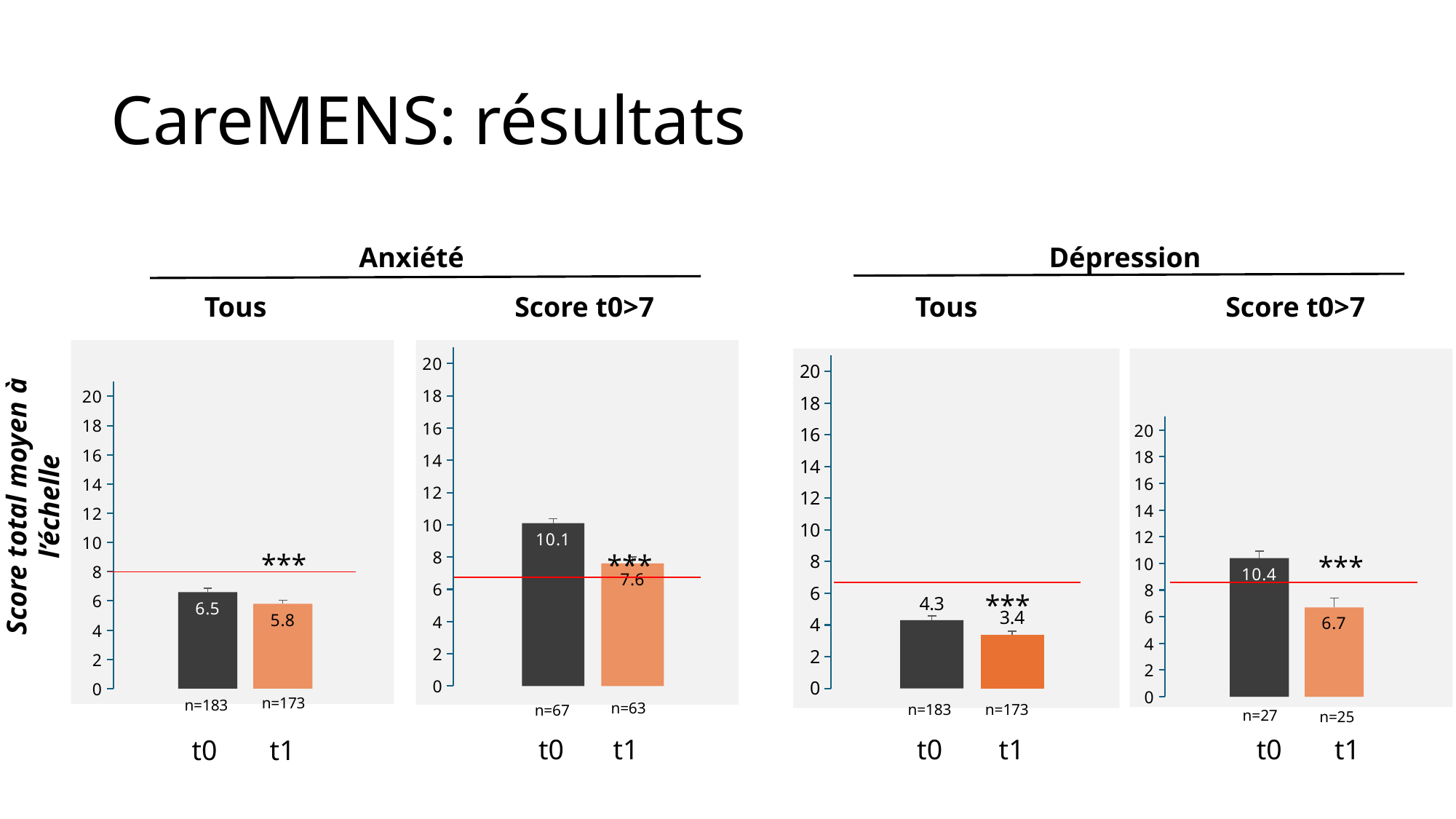
What kind of chart is the Anxiété Score t0>7 chart? bar chart In the Dépression Tous chart, what is the value for t1? 3.4 In the Anxiété Score t0>7 chart, what is the difference between the t0 and t1 values? 2.5 In the Anxiété Tous chart, what is the value for t0? 6.5 In the Dépression Score t0>7 chart, what is the value for t0? 10.4 In the Dépression Score t0>7 chart, what is the value for t1? 6.7 In the Dépression Score t0>7 chart, what is the difference between the t0 and t1 values? 3.7 In the Anxiété Score t0>7 chart, what is the value for t0? 10.1 How many bars are plotted in the Dépression Tous chart? 2 In the Dépression Tous chart, which bar is higher, t0 or t1? t0 In the Anxiété Tous chart, is the value for t0 greater or less than 8? less In the Anxiété Tous chart, what is the value for t1? 5.8